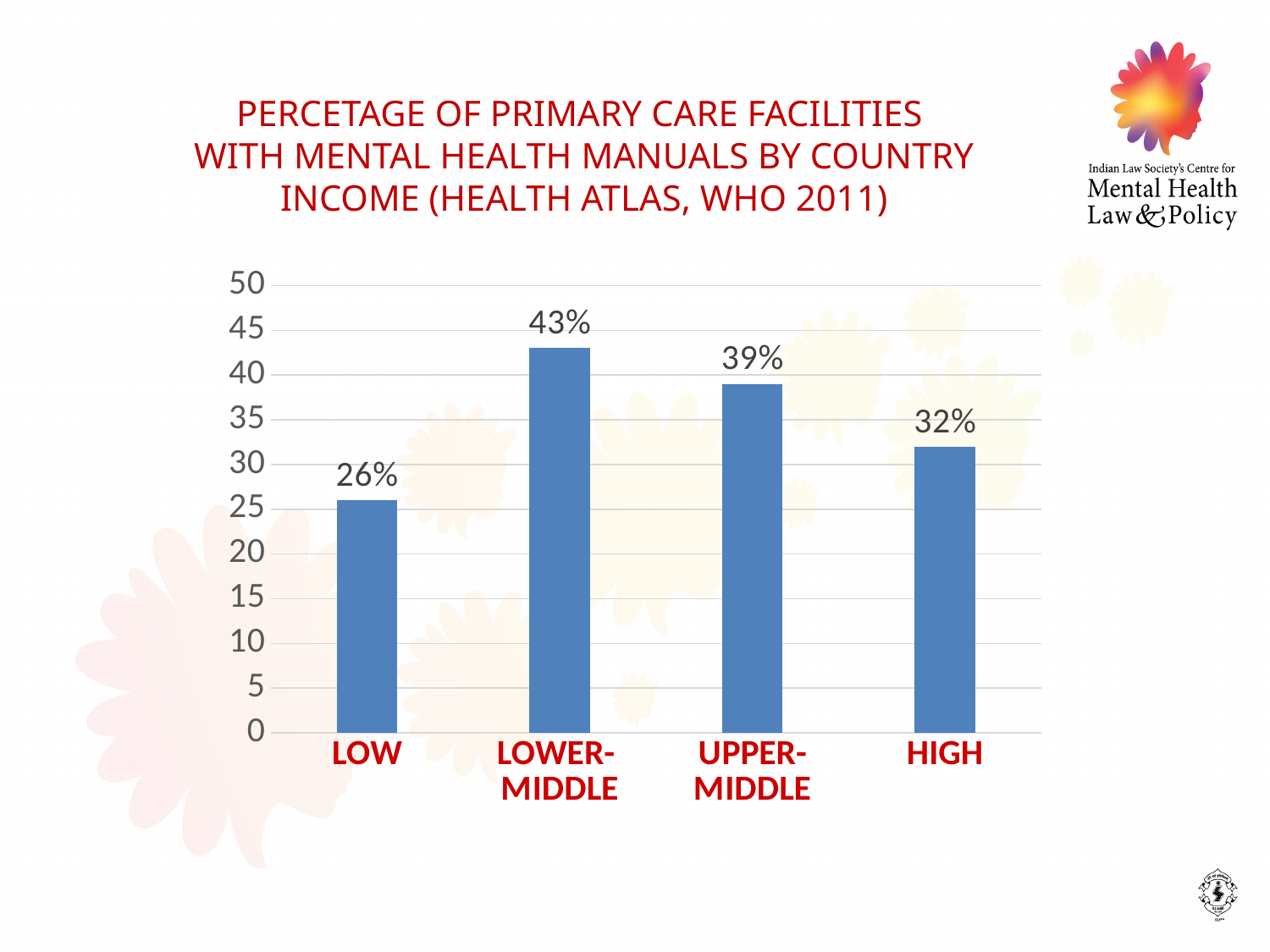
What kind of chart is shown on the slide? bar chart Is the value for UPPER-MIDDLE greater or less than 35? greater Which category has the highest value? LOWER-MIDDLE Which is larger, the value for HIGH or the value for LOW? HIGH Which category has the lowest value? LOW How many categories are shown on the x axis? 4 What is the difference between the values for LOWER-MIDDLE and LOW? 17% What is the value for LOW? 26% What is the difference between the values for UPPER-MIDDLE and HIGH? 7% What is the value for HIGH? 32% What is the value for UPPER-MIDDLE? 39% What is the value for LOWER-MIDDLE? 43%